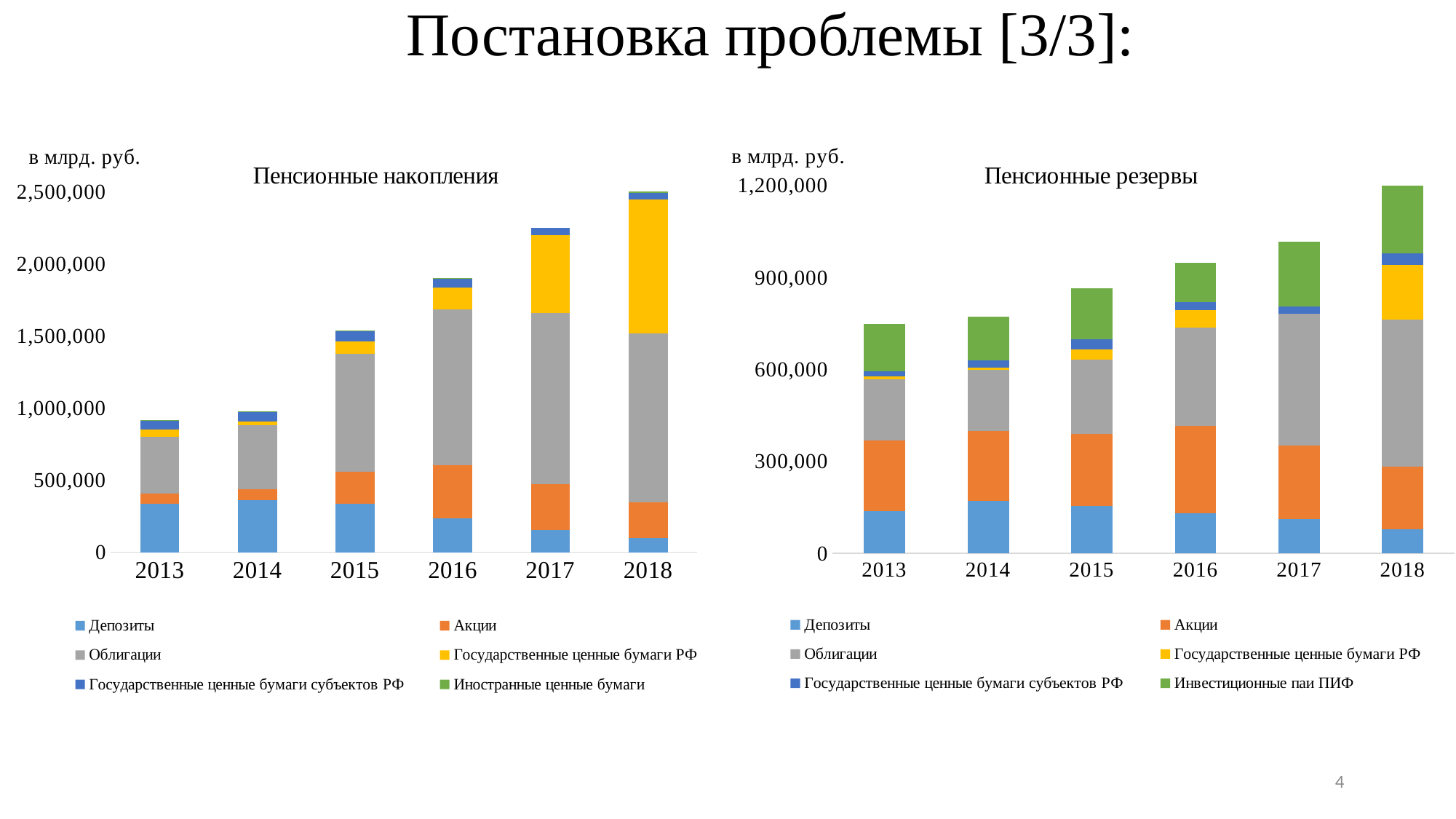
In the "Пенсионные накопления" chart, is the total for 2018 greater or less than 2,000,000? greater What kind of chart is the "Пенсионные накопления" chart? stacked bar chart In the "Пенсионные резервы" chart, is the total for 2013 greater or less than 900,000? less In the "Пенсионные накопления" chart, which year has the highest total bar? 2018 In the "Пенсионные накопления" chart, is the total for 2013 greater or less than 1,000,000? less Which legend entry appears in the "Пенсионные резервы" chart but not in the "Пенсионные накопления" chart? Инвестиционные паи ПИФ In the "Пенсионные резервы" chart, which year has the lowest total bar? 2013 How many series does the legend of the "Пенсионные накопления" chart list? 6 How many years are shown on the x axis of the "Пенсионные резервы" chart? 6 In the "Пенсионные накопления" chart, which year has the lowest total bar? 2013 In the "Пенсионные резервы" chart, which year has the highest total bar? 2018 Do the total bars in the "Пенсионные резервы" chart rise or fall from 2013 to 2018? rise